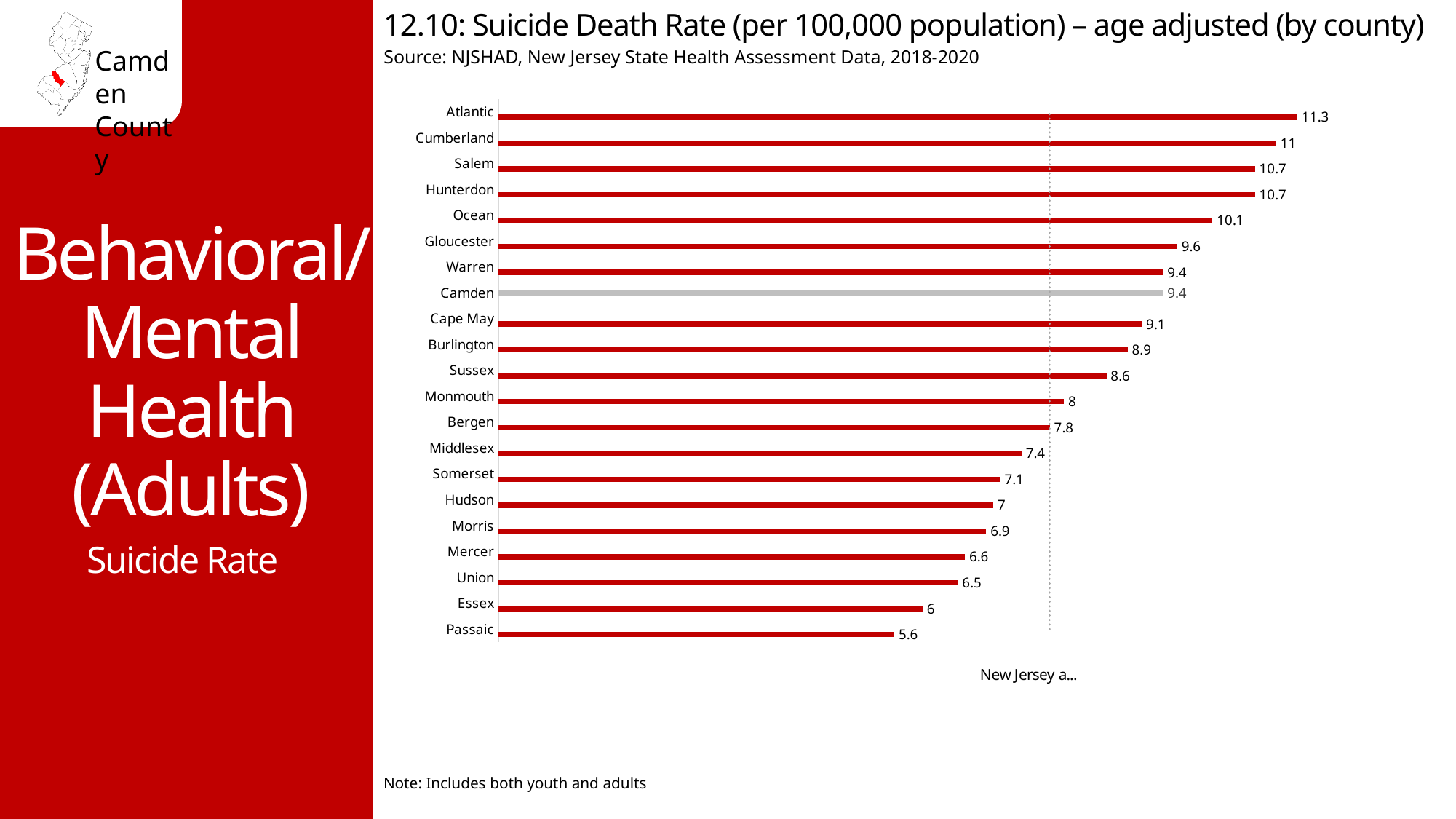
Which county has the lowest suicide death rate? Passaic What is the suicide death rate for Atlantic county? 11.3 Which county's bar is shown in gray rather than red? Camden What is the suicide death rate for Passaic county? 5.6 What is the difference between the suicide death rates of Camden and Bergen counties? 1.6 What type of chart is used on this slide? Bar chart Which county has a higher suicide death rate, Essex or Ocean? Ocean What is the suicide death rate for Camden county? 9.4 What is the difference between the suicide death rates of Atlantic and Passaic counties? 5.7 Which county has the highest suicide death rate? Atlantic How many counties are shown in the chart? 21 Which county has a higher suicide death rate, Gloucester or Burlington? Gloucester